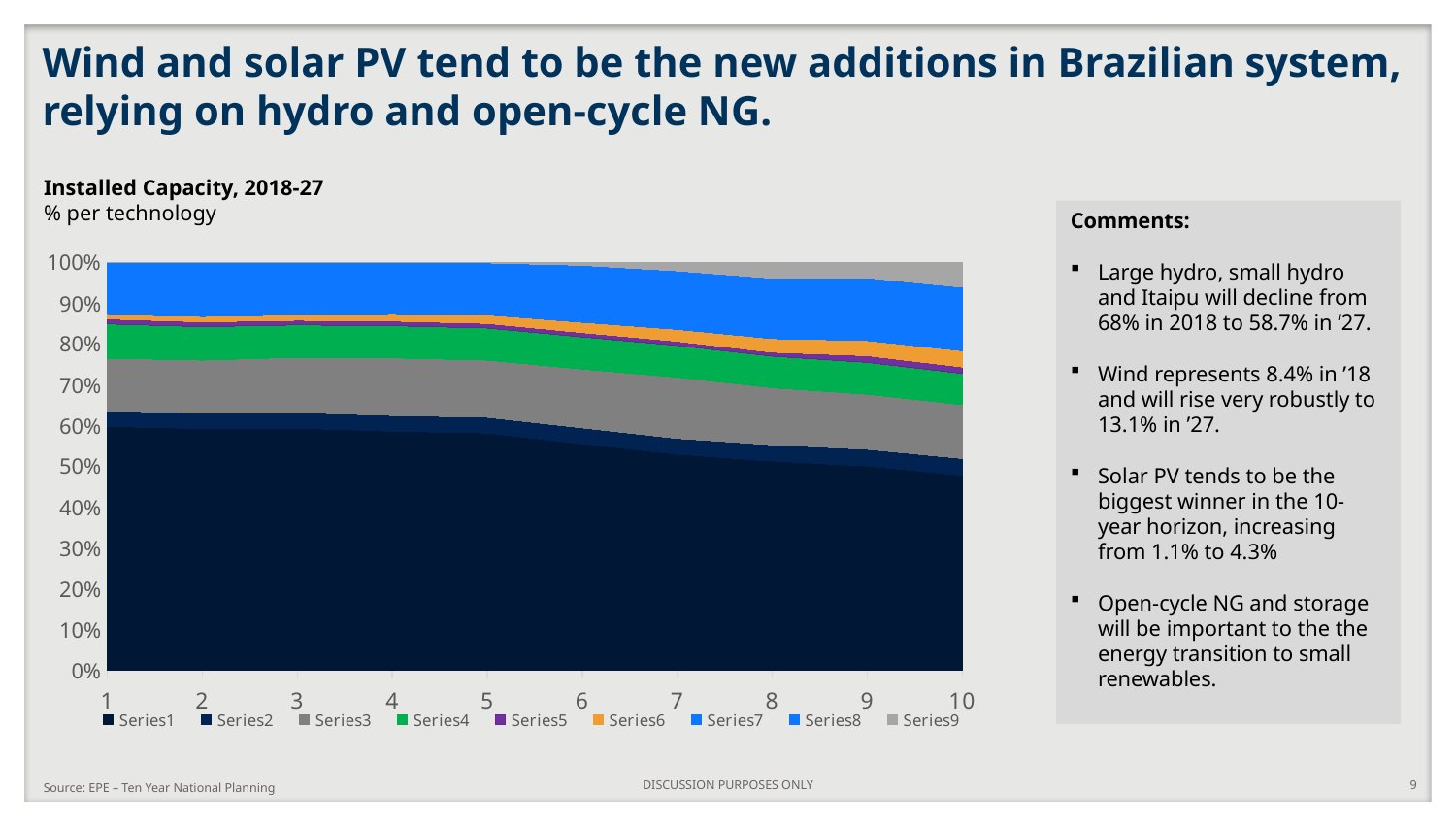
How many series does the legend list? 9 How many points are there along the x axis? 10 Does the top boundary of Series1 rise or fall from x = 1 to x = 10? Fall Is the value for Series1 at x = 1 greater or less than 50%? greater What is the highest value shown on the y axis? 100% What is the title of the chart? Installed Capacity, 2018-27 What kind of chart is shown on the slide? Area chart Does the band for Series7 get wider or narrower from x = 1 to x = 10? Wider Is the value for Series1 at x = 1 greater or less than 70%? less Is the value for Series1 at x = 10 greater or less than 60%? less What unit does the chart subtitle say the values are in? % per technology